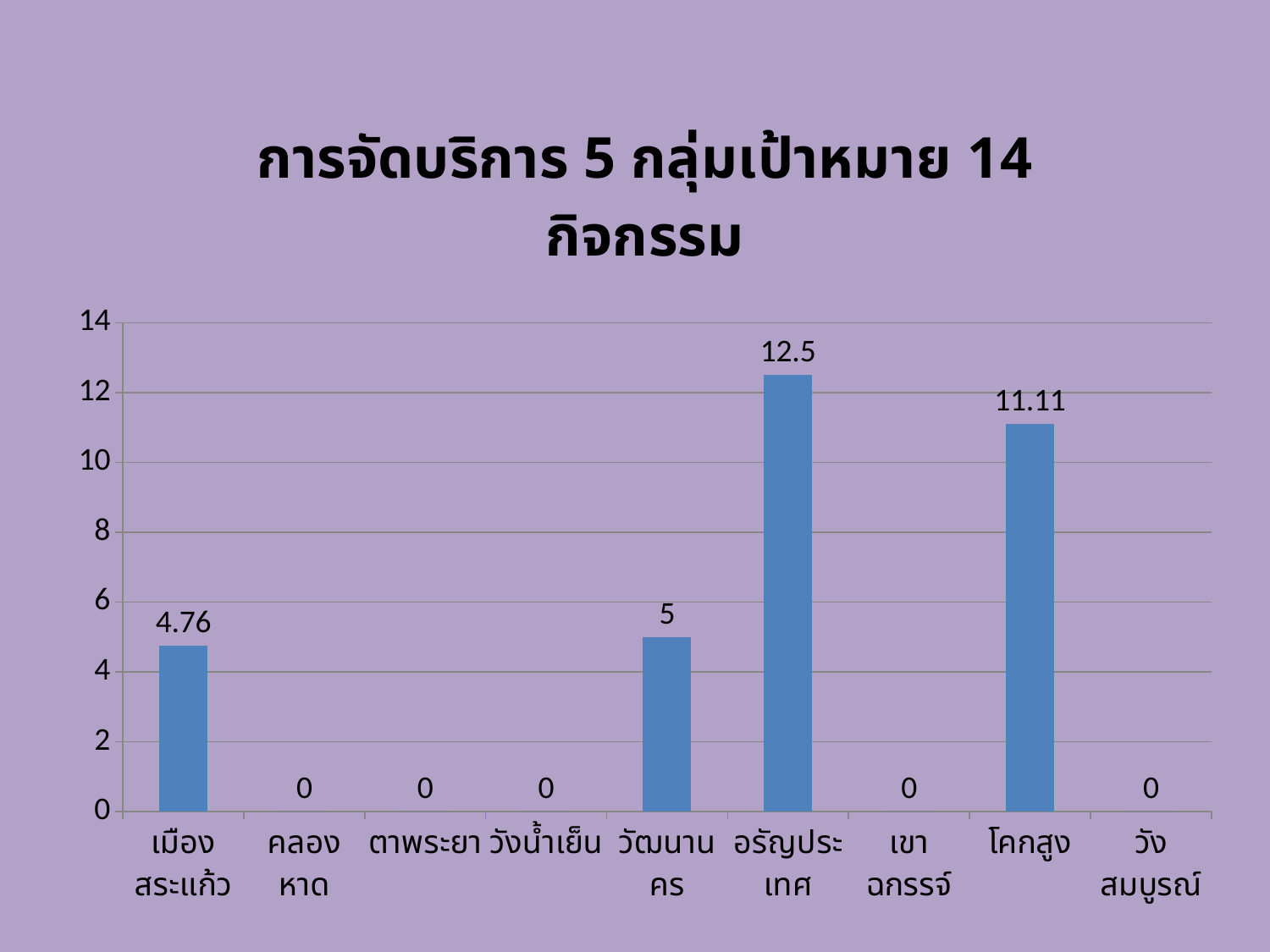
What is the value for วัฒนานคร? 5 How many categories are shown on the x axis? 9 What is the value for เมืองสระแก้ว? 4.76 What is the value for อรัญประเทศ? 12.5 Which is larger, the value for โคกสูง or the value for วัฒนานคร? โคกสูง What is the difference between the values for วัฒนานคร and เมืองสระแก้ว? 0.24 What is the value for โคกสูง? 11.11 What is the difference between the values for อรัญประเทศ and โคกสูง? 1.39 What is the title of the chart? การจัดบริการ 5 กลุ่มเป้าหมาย 14 กิจกรรม How many categories have a value of 0? 5 Which category has the highest value? อรัญประเทศ What kind of chart is shown on the slide? Bar chart